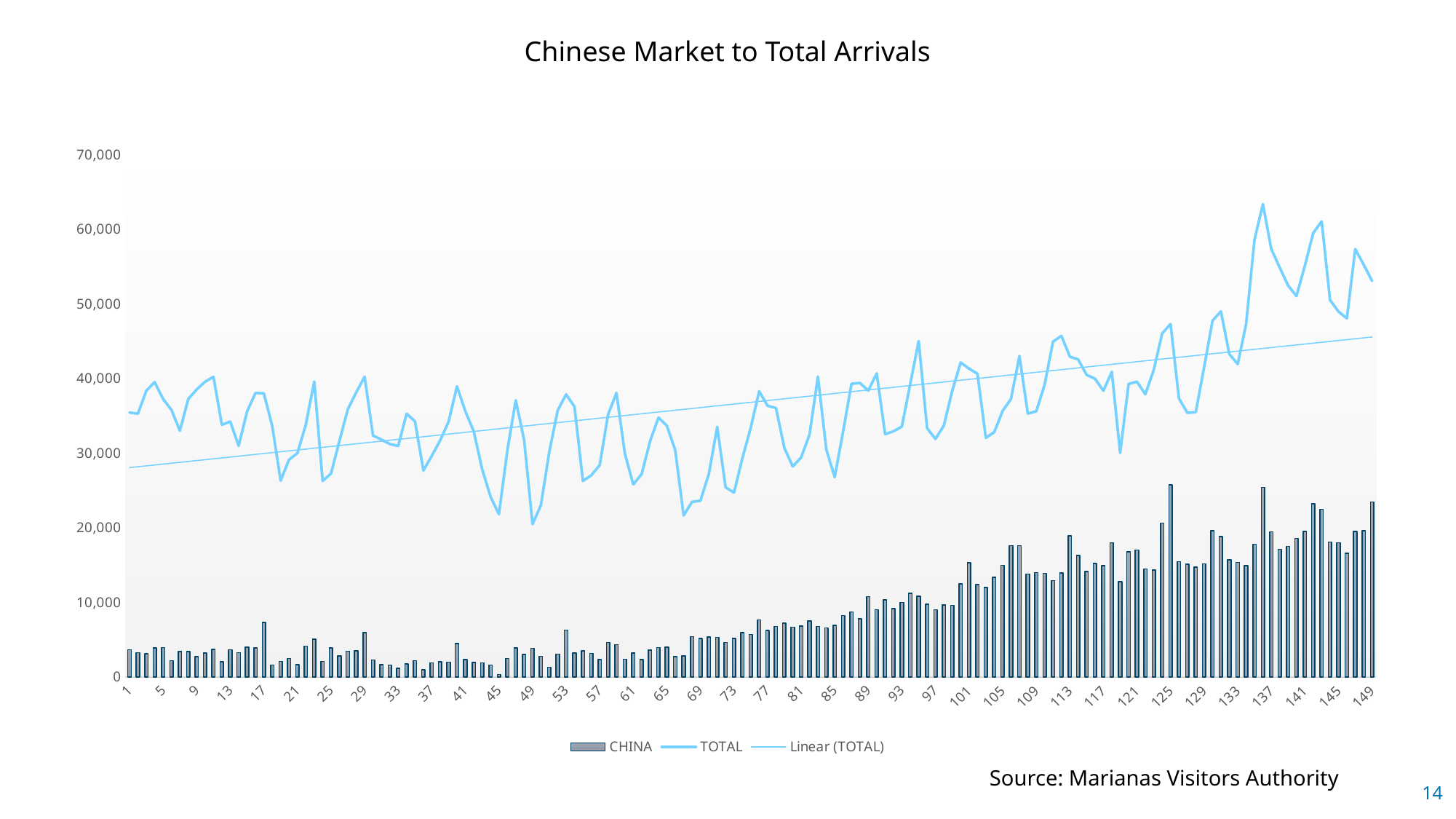
Is the TOTAL value at point 49 greater or less than 30,000? less Is the CHINA value at point 1 greater or less than 10,000? less What kind of chart is this? Combined bar and line chart Is the CHINA value at point 125 greater or less than 20,000? greater How many series does the legend list? 3 Which is larger at point 149, the TOTAL value or the CHINA value? TOTAL Which series is drawn as bars? CHINA Does the TOTAL line generally rise or fall from left to right along the x axis? rise Do the CHINA bars generally rise or fall from left to right along the x axis? rise What is the last label shown on the x axis? 149 What is the title of the chart? Chinese Market to Total Arrivals